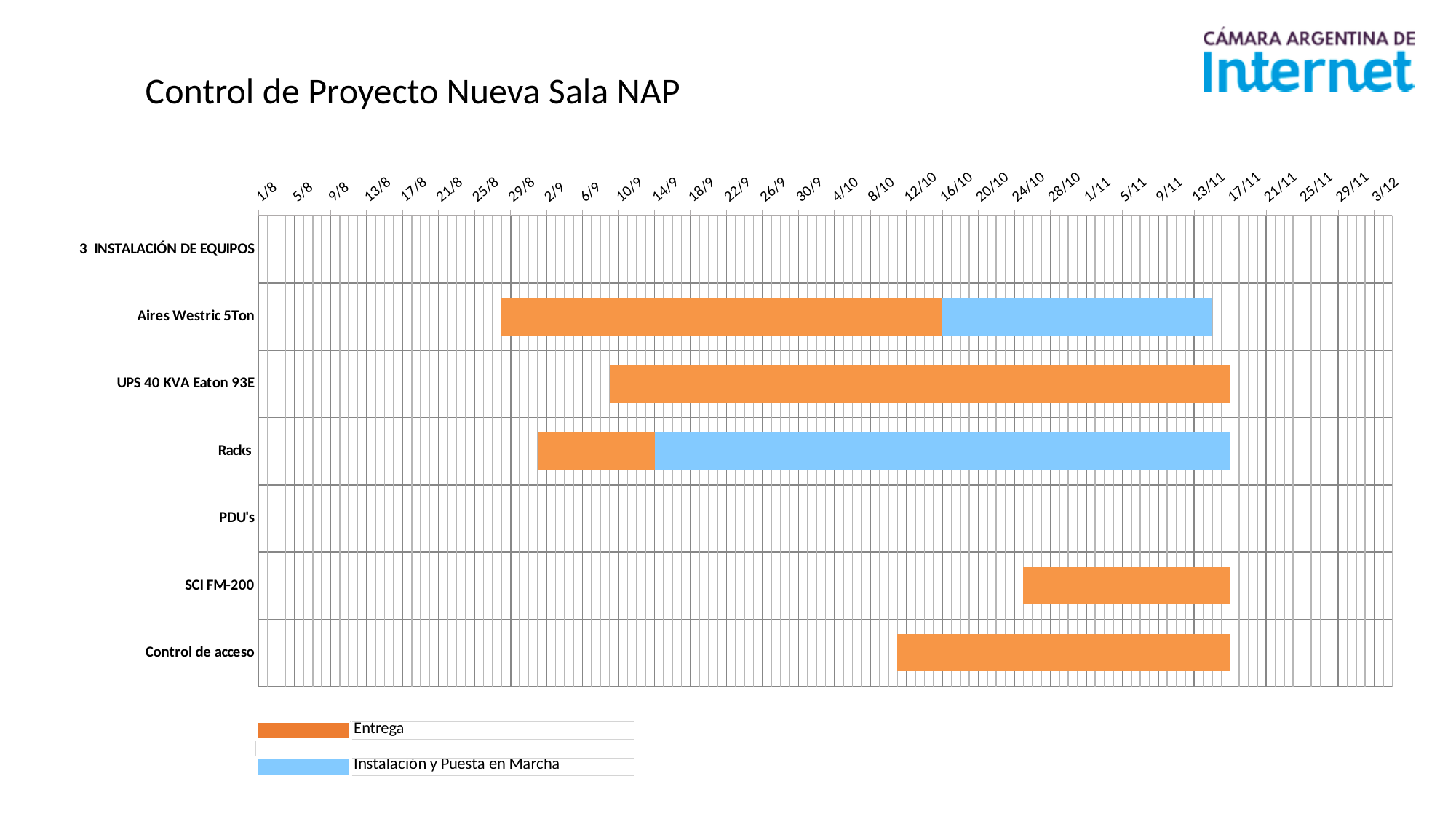
What are the two legend entries? Entrega; Instalación y Puesta en Marcha Which task has the longest 'Entrega' (orange) segment? UPS 40 KVA Eaton 93E Which tasks have an 'Instalación y Puesta en Marcha' (blue) segment? Aires Westric 5Ton and Racks How many series does the legend list? 2 Which task's bar starts latest on the timeline? SCI FM-200 Which colour represents 'Instalación y Puesta en Marcha' in the legend? light blue Which task's bar starts earliest on the timeline? Aires Westric 5Ton What kind of chart is shown on the slide? bar chart (Gantt chart) How many task rows are listed on the vertical axis of the chart? 7 Does the bar for Control de acceso start before or after 1/10? after Which task has the shortest bar overall? SCI FM-200 How many tasks have a bar plotted in the chart? 5